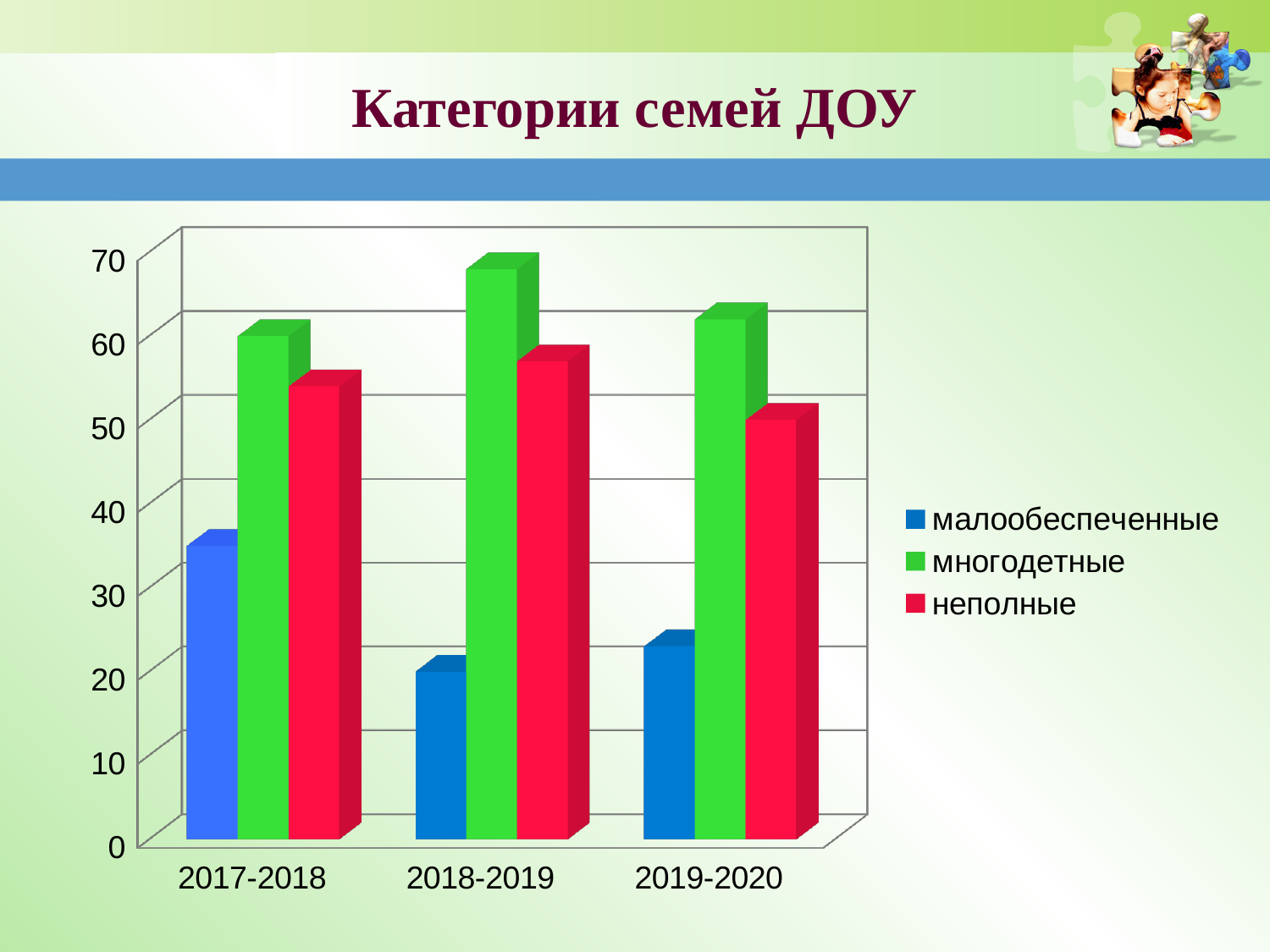
How many series does the legend list? 3 How many year categories are shown on the x axis? 3 What is the title of the slide? Категории семей ДОУ Which series is shown in green? многодетные In which year is the value for малообеспеченные the lowest? 2018-2019 Is the value for малообеспеченные in 2018-2019 greater or less than 30? less Is the value for неполные in 2018-2019 greater or less than 50? greater In 2017-2018, which is larger: многодетные or неполные? многодетные Between 2017-2018 and 2018-2019, does the value for малообеспеченные rise or fall? fall In which year is the value for многодетные the highest? 2018-2019 What kind of chart is shown on the slide? bar chart Is the value for многодетные in 2018-2019 greater or less than 60? greater